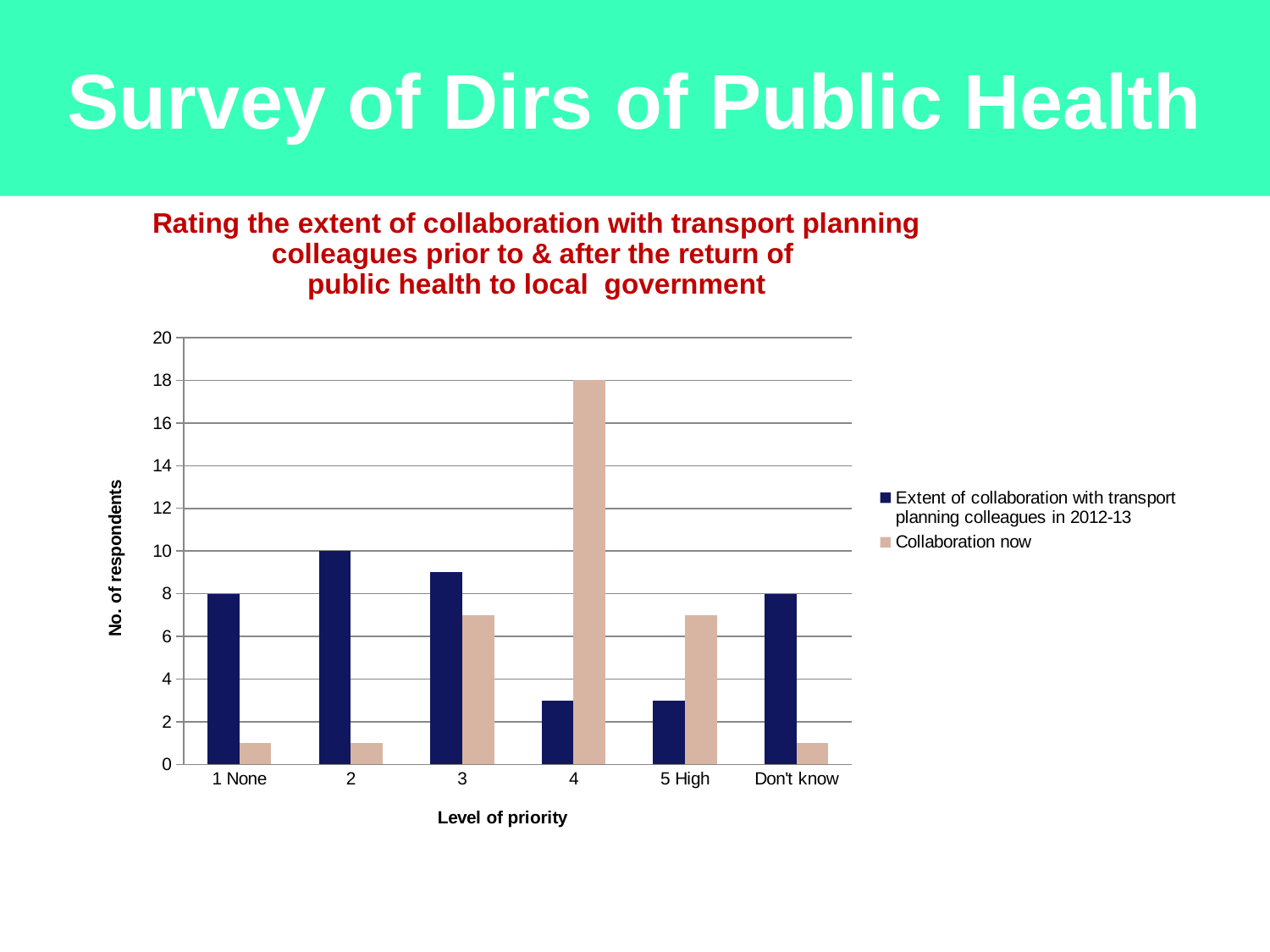
What type of chart is shown on the slide? Bar chart What is the title of the y axis? No. of respondents Which level of priority has the highest value in the 'Extent of collaboration with transport planning colleagues in 2012-13' series? 2 What is the value for '2' in the 'Extent of collaboration with transport planning colleagues in 2012-13' series? 10 For level of priority '4', which series has the larger value? Collaboration now Is the 'Collaboration now' value for '3' greater or less than 8? less What is the difference between the 2012-13 values for '2' and '1 None'? 2 What is the value for '1 None' in the 'Extent of collaboration with transport planning colleagues in 2012-13' series? 8 What is the value for '4' in the 'Collaboration now' series? 18 Which level of priority has the highest value in the 'Collaboration now' series? 4 How many categories are shown on the x axis? 6 How many series does the legend list? 2